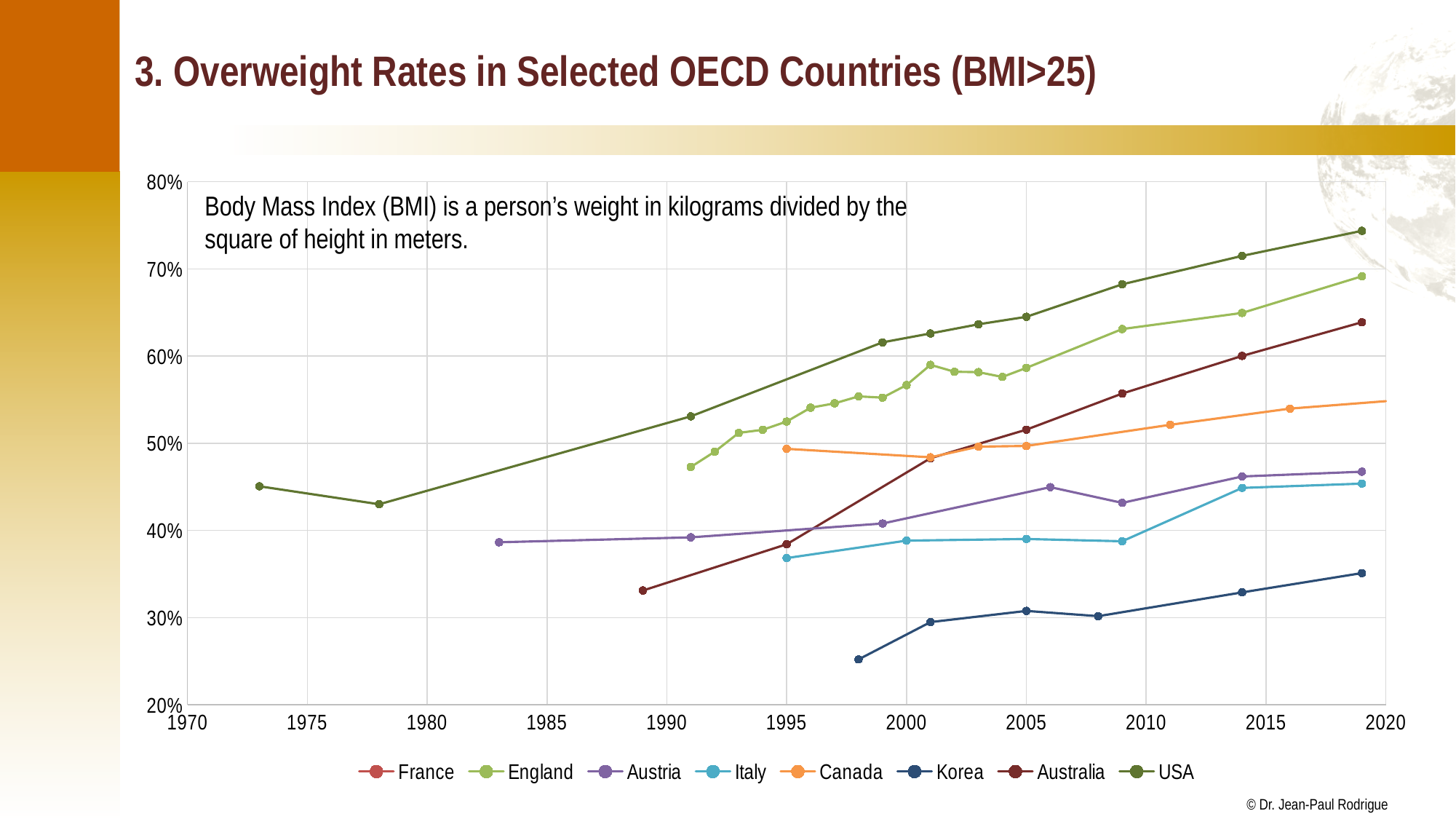
How many series does the legend list? 8 Which country has the highest overweight rate in 2019? USA Is the value for Canada in 2019 greater or less than 50%? greater In 2019, which is higher, the value for Korea or the value for Italy? Italy Which country has the lowest overweight rate in 2019? Korea What is the title of the chart? 3. Overweight Rates in Selected OECD Countries (BMI>25) Is the value for Korea in 1998 greater or less than 30%? less Is the value for USA in 2019 greater or less than 70%? greater What kind of chart is shown on the slide? line chart Does the overweight rate for Korea rise or fall from 1998 to 2019? rise In 2019, which is higher, the value for Australia or the value for Canada? Australia